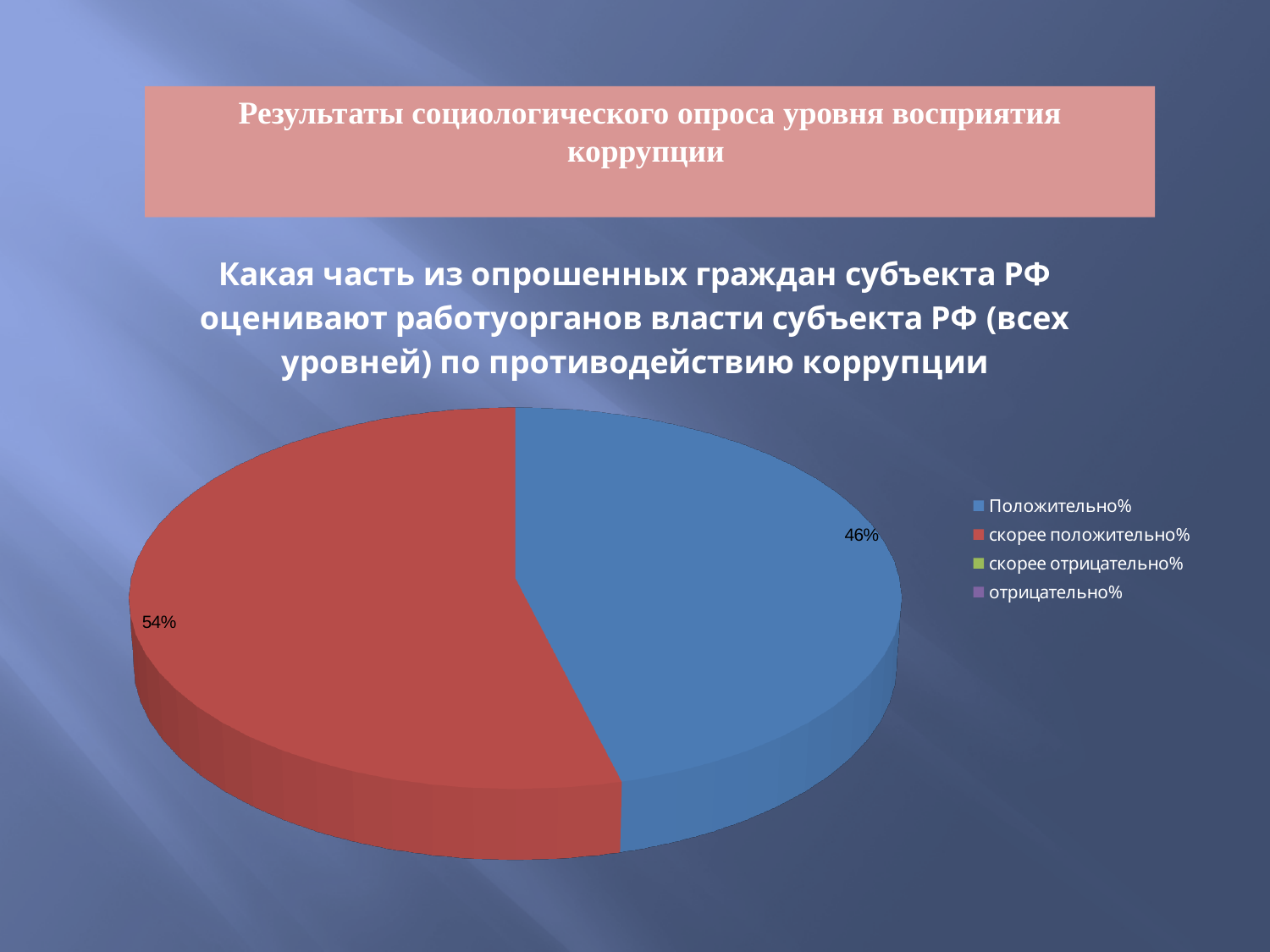
What kind of chart is shown on the slide? Pie chart Which slice of the pie chart is the largest? скорее положительно% How many entries does the legend of the pie chart list? 4 Which is larger: the "Положительно%" slice or the "скорее положительно%" slice? скорее положительно% What percentage of the pie chart is labelled for the "Положительно%" slice? 46% What colour is the "скорее положительно%" slice in the pie chart? Red How many slices are visibly plotted in the pie chart? 2 What percentage of the pie chart is labelled for the "скорее положительно%" slice? 54% Which legend entry is shown with a blue marker? Положительно% What is the difference in percentage points between the "скорее положительно%" slice and the "Положительно%" slice? 8 What is the combined share of the "Положительно%" and "скорее положительно%" slices? 100% Which of the two labelled slices of the pie chart is the smallest? Положительно%